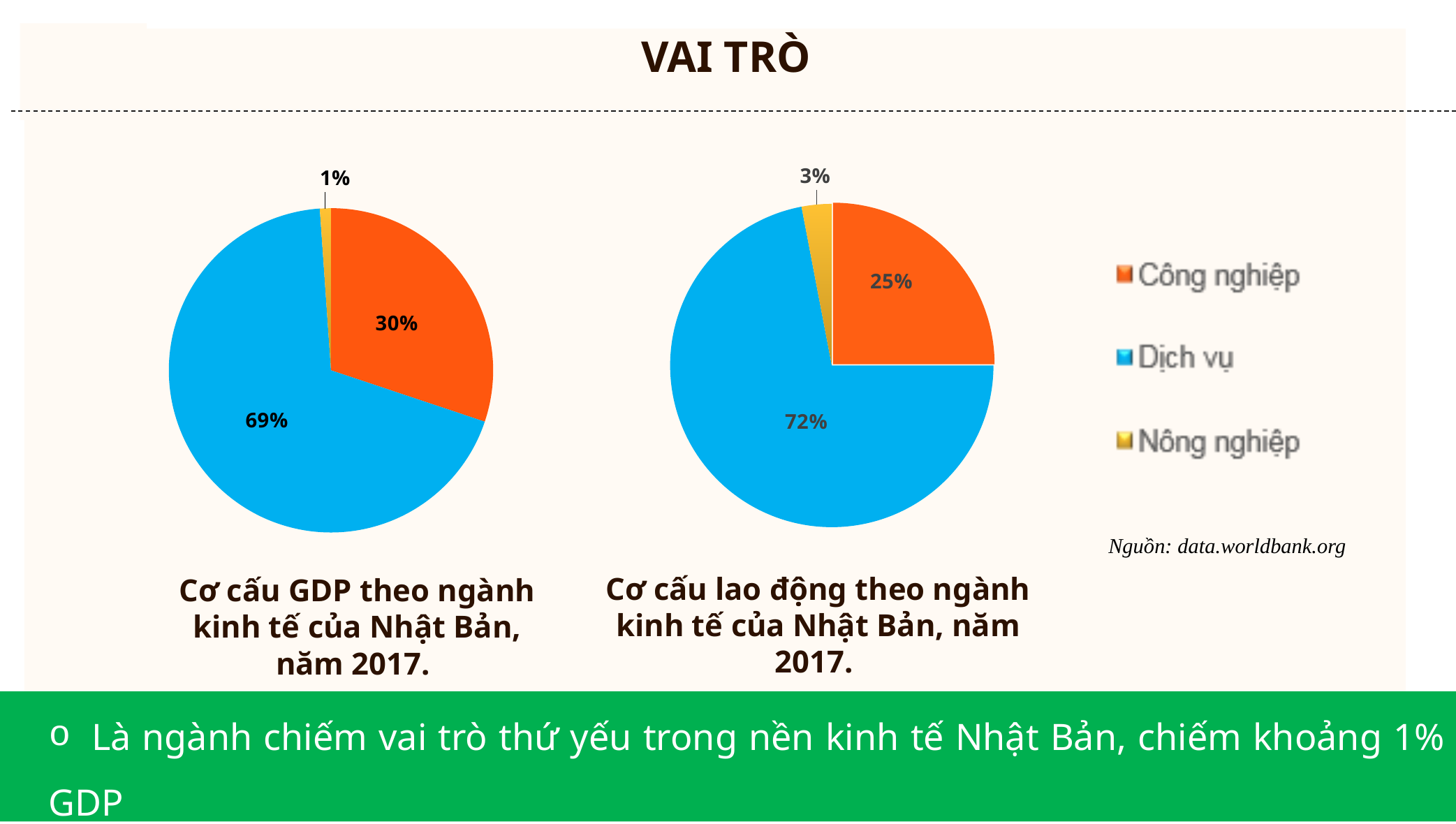
How many sectors does the legend list for the charts? 3 In the left chart (Cơ cấu GDP theo ngành kinh tế của Nhật Bản, năm 2017), what share does Nông nghiệp have? 1% In the right chart (Cơ cấu lao động theo ngành kinh tế của Nhật Bản, năm 2017), what share does Nông nghiệp have? 3% Which chart shows a larger share for Công nghiệp, the left chart (Cơ cấu GDP) or the right chart (Cơ cấu lao động)? The left chart (Cơ cấu GDP) In the left chart (Cơ cấu GDP theo ngành kinh tế của Nhật Bản, năm 2017), what is the difference between the shares of Dịch vụ and Công nghiệp? 39% In the right chart (Cơ cấu lao động theo ngành kinh tế của Nhật Bản, năm 2017), which sector has the largest share? Dịch vụ In the left chart (Cơ cấu GDP theo ngành kinh tế của Nhật Bản, năm 2017), what share does Công nghiệp have? 30% In the left chart (Cơ cấu GDP theo ngành kinh tế của Nhật Bản, năm 2017), what share does Dịch vụ have? 69% In the left chart (Cơ cấu GDP theo ngành kinh tế của Nhật Bản, năm 2017), which sector has the smallest share? Nông nghiệp What type of chart is used for the left chart (Cơ cấu GDP theo ngành kinh tế của Nhật Bản, năm 2017)? Pie chart In the right chart (Cơ cấu lao động theo ngành kinh tế của Nhật Bản, năm 2017), what is the difference between the shares of Công nghiệp and Nông nghiệp? 22% In the right chart (Cơ cấu lao động theo ngành kinh tế của Nhật Bản, năm 2017), what share does Dịch vụ have? 72%